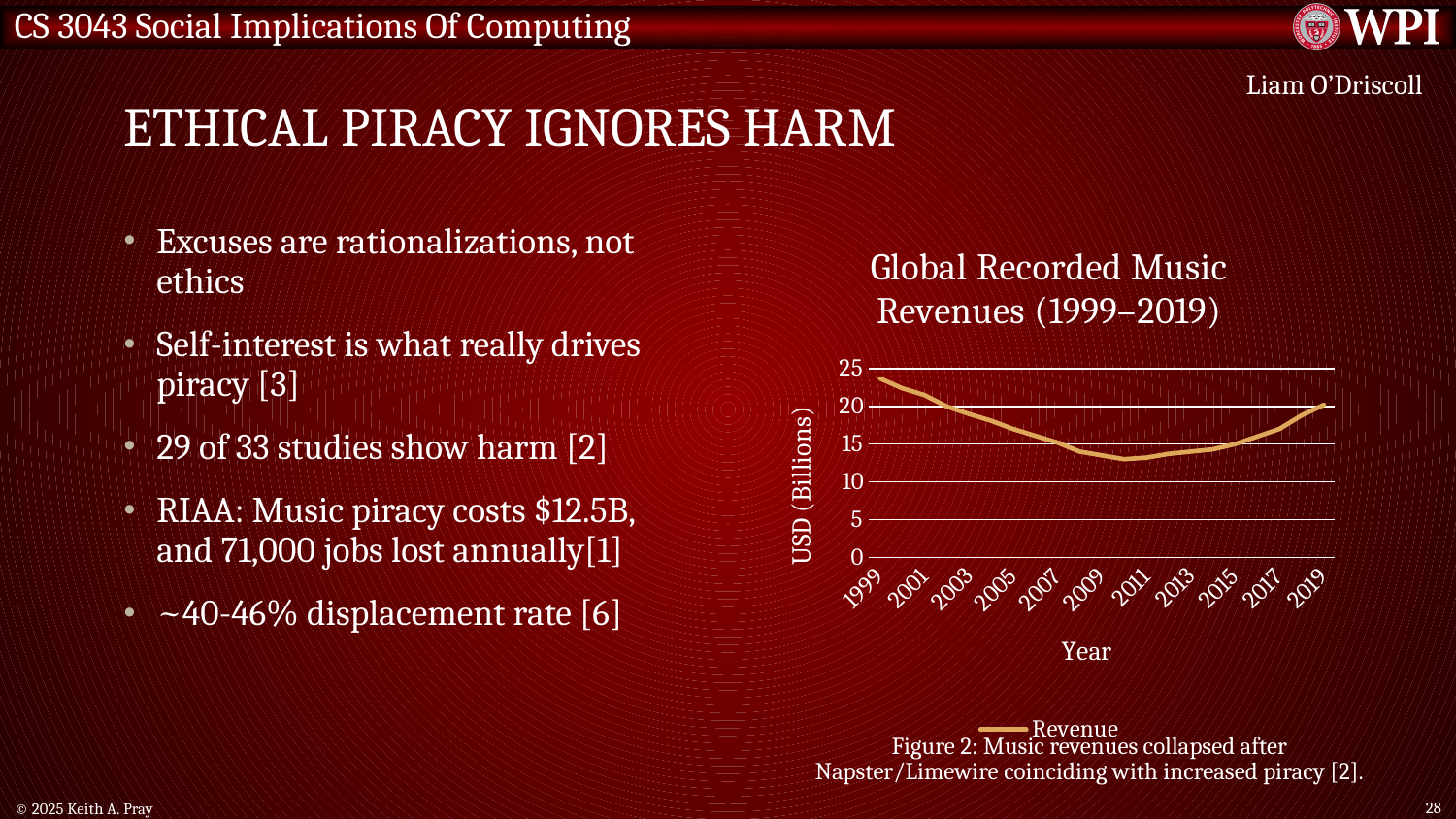
What is the label of the y axis? USD (Billions) Does revenue rise or fall between 1999 and 2009? fall Which year has the highest revenue on the chart? 1999 Is the revenue value for 1999 greater or less than 20? greater Is the revenue value for 2003 greater or less than 15? greater Which is larger, the revenue in 1999 or the revenue in 2019? 1999 How many series does the chart's legend list? 1 Is the revenue value for 2011 greater or less than 15? less Does revenue rise or fall between 2013 and 2019? rise What is the title of the chart? Global Recorded Music Revenues (1999–2019) What kind of chart is shown on the slide? line chart